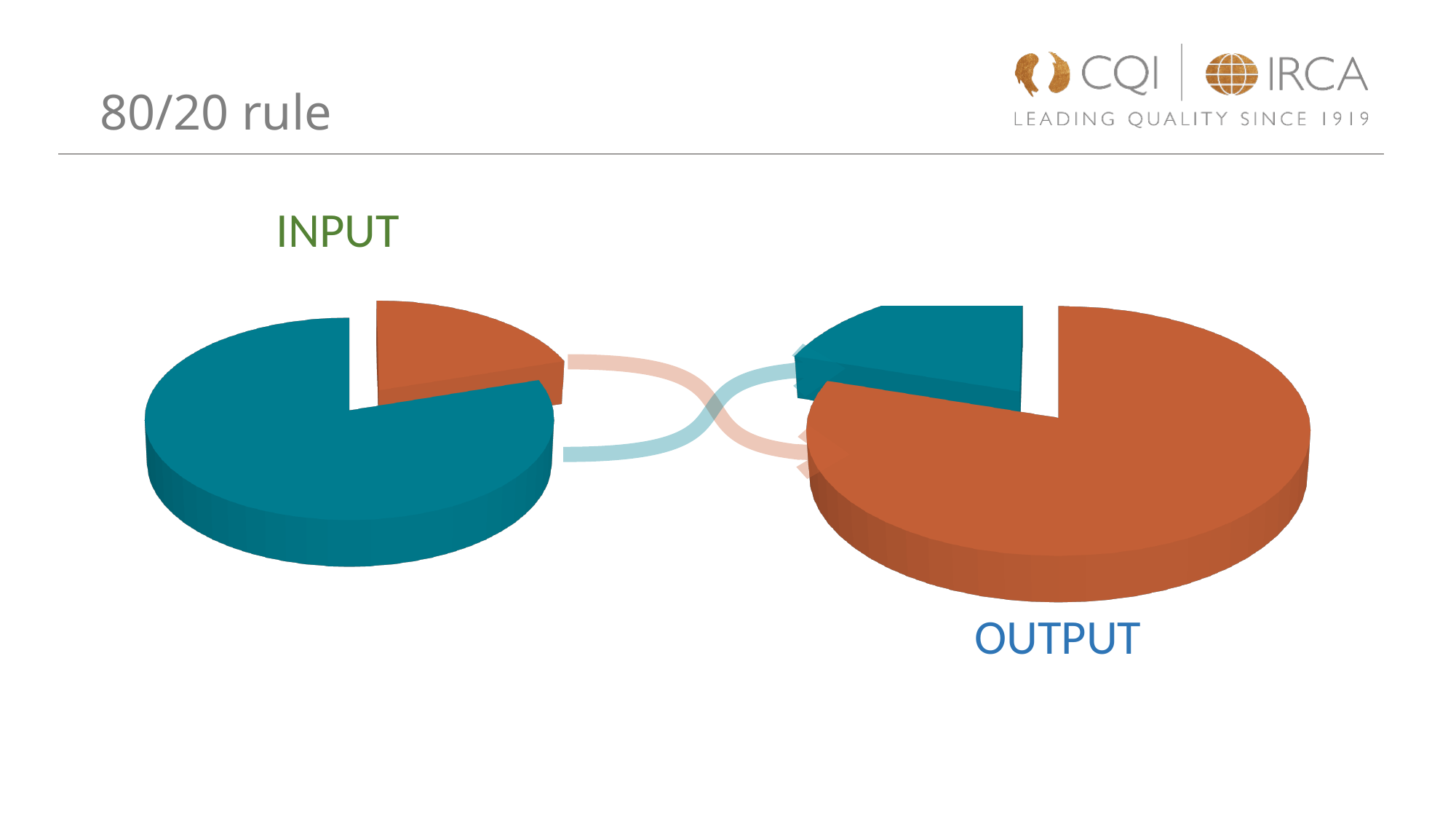
In the OUTPUT pie chart, which slice is larger, the teal one or the orange one? The orange one How many pie charts are shown on the slide? 2 In the INPUT pie chart, which slice is larger, the teal one or the orange one? The teal one What is the title of the slide containing the two pie charts? 80/20 rule What is the label of the pie chart on the left of the slide? INPUT In the INPUT pie chart, which colour is the smallest slice? Orange In the OUTPUT pie chart, which colour is the smallest slice? Teal How many slices does the INPUT pie chart have? 2 How many slices does the OUTPUT pie chart have? 2 What kind of chart is the OUTPUT chart? Pie chart What kind of chart is the INPUT chart? Pie chart